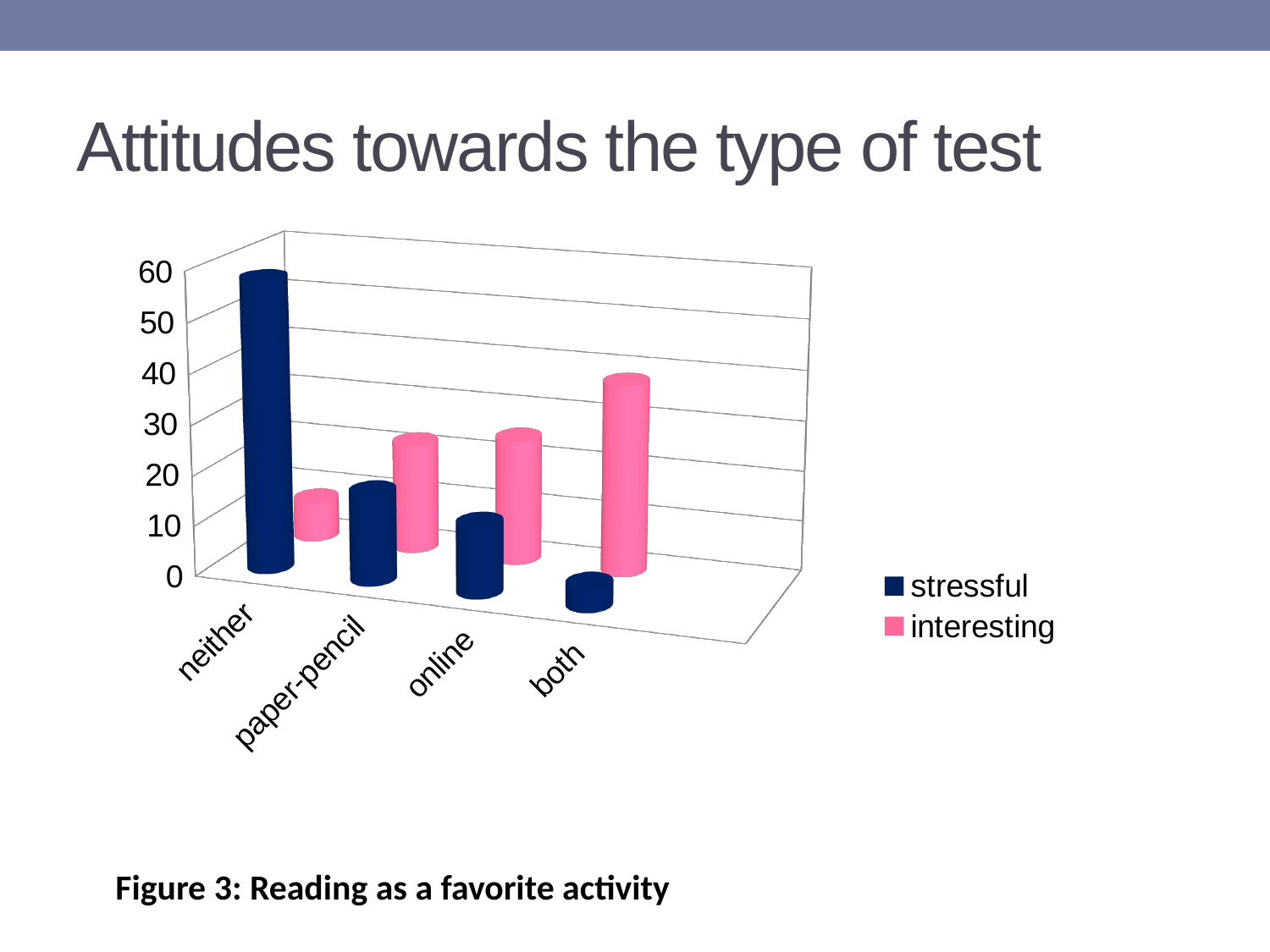
Which category has the lowest value for the 'interesting' series? neither Is the 'stressful' value for 'neither' greater or less than 50? greater For the 'neither' category, which series has the larger value, 'stressful' or 'interesting'? stressful Do the 'stressful' values rise or fall from 'neither' to 'both' along the x axis? fall How many series does the legend list? 2 Is the 'interesting' value for 'both' greater or less than 30? greater How many categories are shown on the x axis? 4 What kind of chart is shown on the slide? bar chart Is the 'stressful' value for 'both' greater or less than 10? less Which category has the highest value for the 'interesting' series? both Which category has the lowest value for the 'stressful' series? both Which category has the highest value for the 'stressful' series? neither